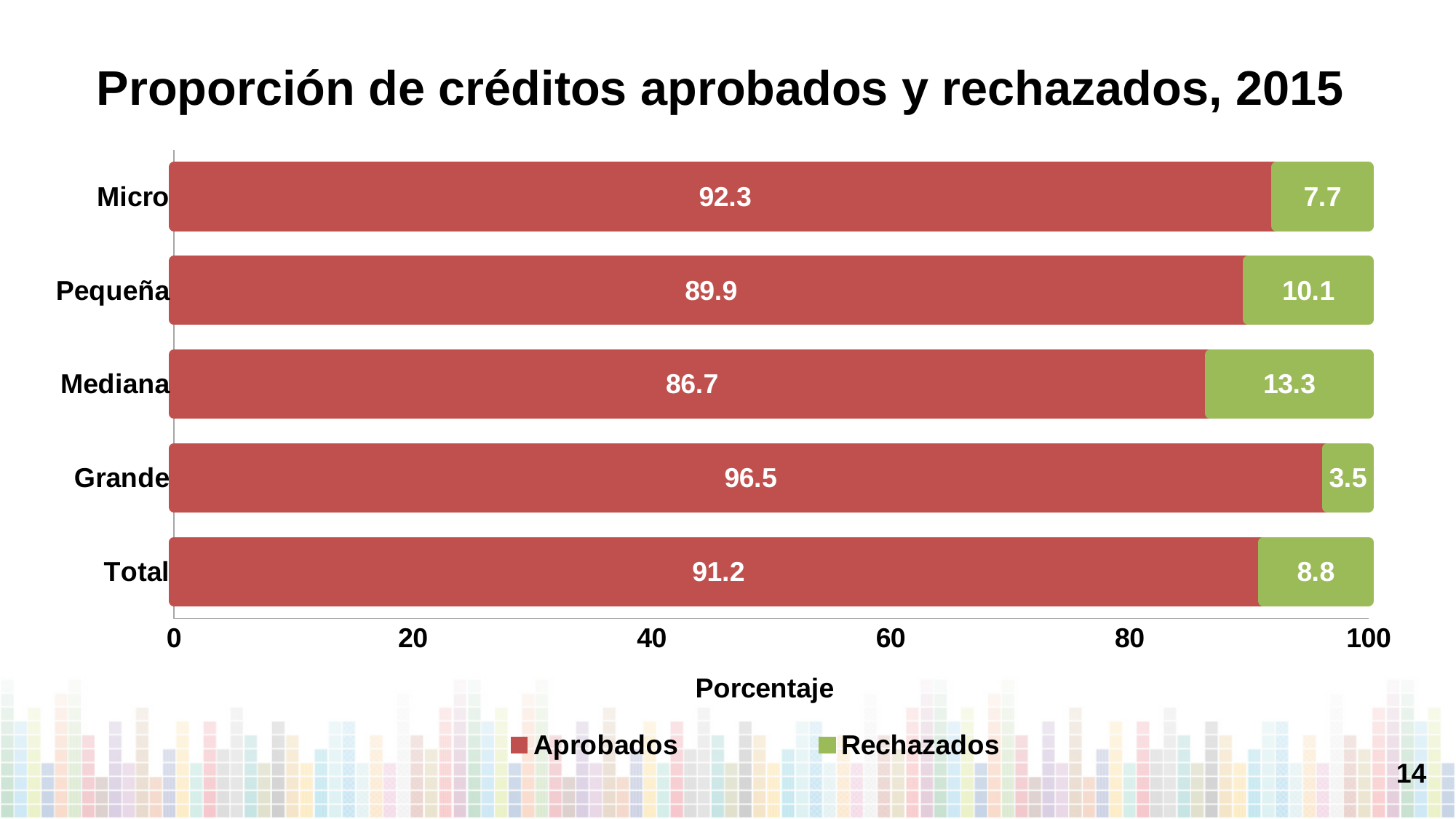
What kind of chart is shown on the slide? Stacked bar chart Which category has the highest Aprobados value? Grande Which category has the lowest Rechazados value? Grande Which is larger, the Aprobados value for Pequeña or for Mediana? Pequeña What is the Aprobados value for Total? 91.2 What is the total of the stacked bar for Grande? 100 What is the Rechazados value for Mediana? 13.3 What is the title of the chart? Proporción de créditos aprobados y rechazados, 2015 What is the Aprobados value for Micro? 92.3 How many categories are shown on the y axis? 5 What is the difference between the Rechazados values for Mediana and Micro? 5.6 How many series does the legend list? 2